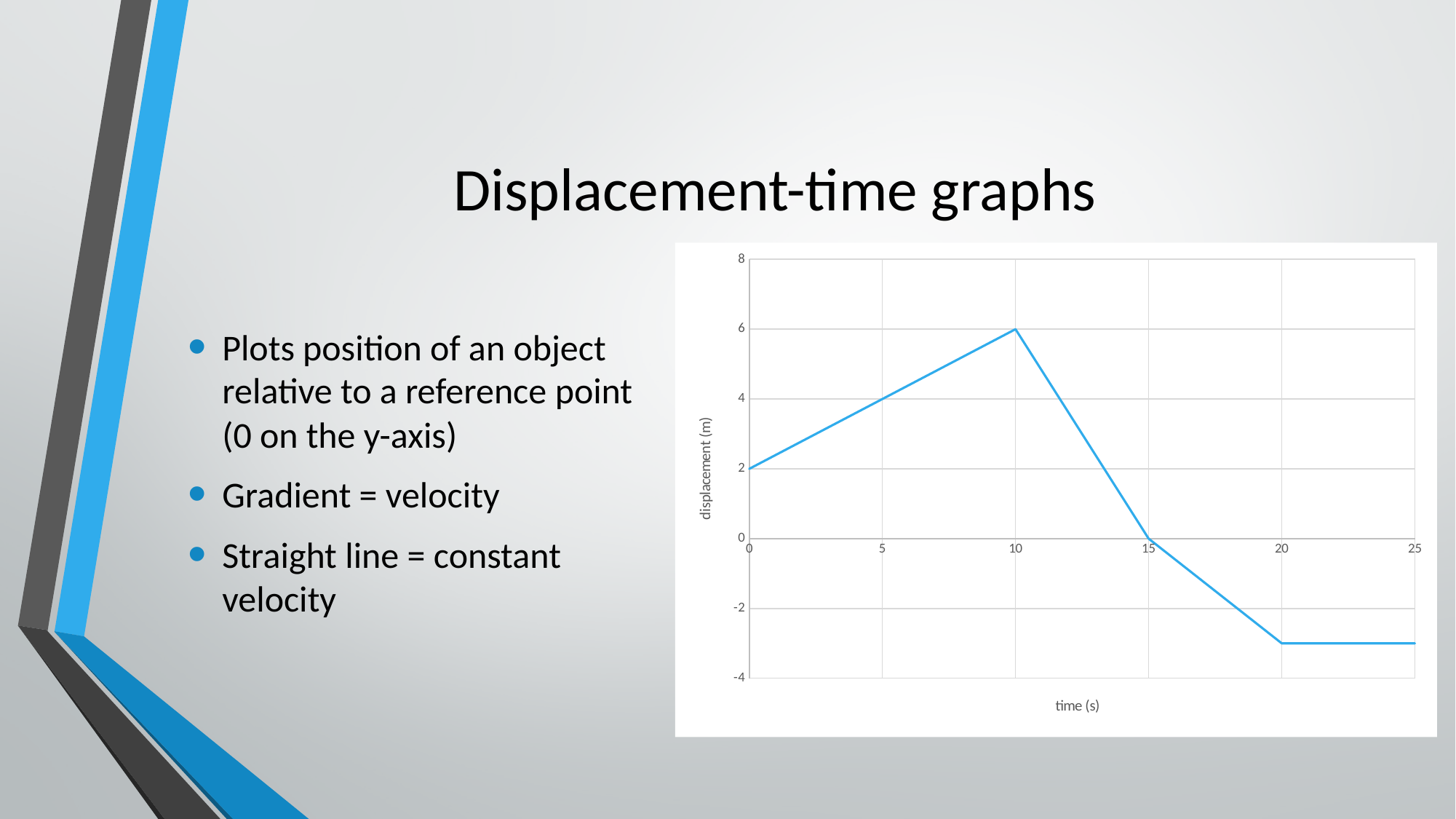
What is the label of the x axis? time (s) Is the displacement at 5 s greater or less than 2? greater Does the displacement rise or fall between 10 s and 15 s? fall What is the difference between the displacement at 10 s and at 0 s? 4 At what time does the displacement reach its highest value? 10 What is the displacement at time 0 s? 2 What is the displacement at time 15 s? 0 What kind of chart is shown on the slide? line chart Is the displacement at 20 s greater or less than -2? less Which is larger, the displacement at 0 s or at 10 s? 10 s What is the displacement at time 10 s? 6 What is the label of the y axis? displacement (m)